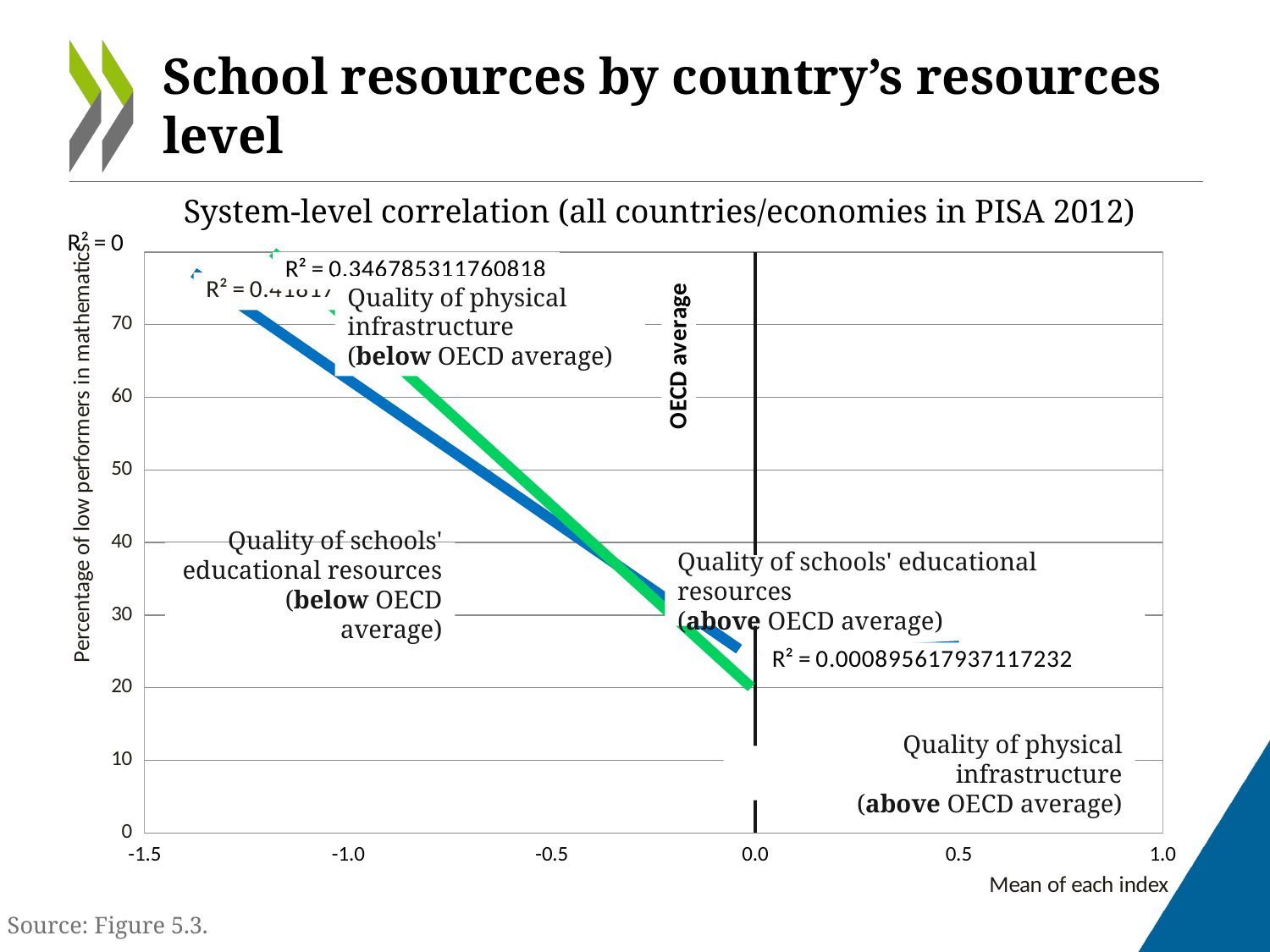
What R² value is printed next to the 'Quality of schools' educational resources (above OECD average)' label? R² = 0.000895617937117232 Is the value of the green trend line at x = 0.0 greater or less than 30? less Do the trend lines rise or fall as the mean of each index increases along the x axis? fall What R² value is printed above the 'Quality of physical infrastructure (below OECD average)' label? R² = 0.346785311760818 Is the value of the blue trend line at x = -1.0 greater or less than 50? greater Is the value of the blue trend line at x = 0.0 greater or less than 30? less What kind of chart is shown on the slide? scatter chart What is the highest tick label shown on the x axis? 1.0 What is the lowest tick label shown on the x axis? -1.5 What is the label of the vertical axis? Percentage of low performers in mathematics What is the title of the chart? System-level correlation (all countries/economies in PISA 2012) How many tick labels are shown on the x axis? 6